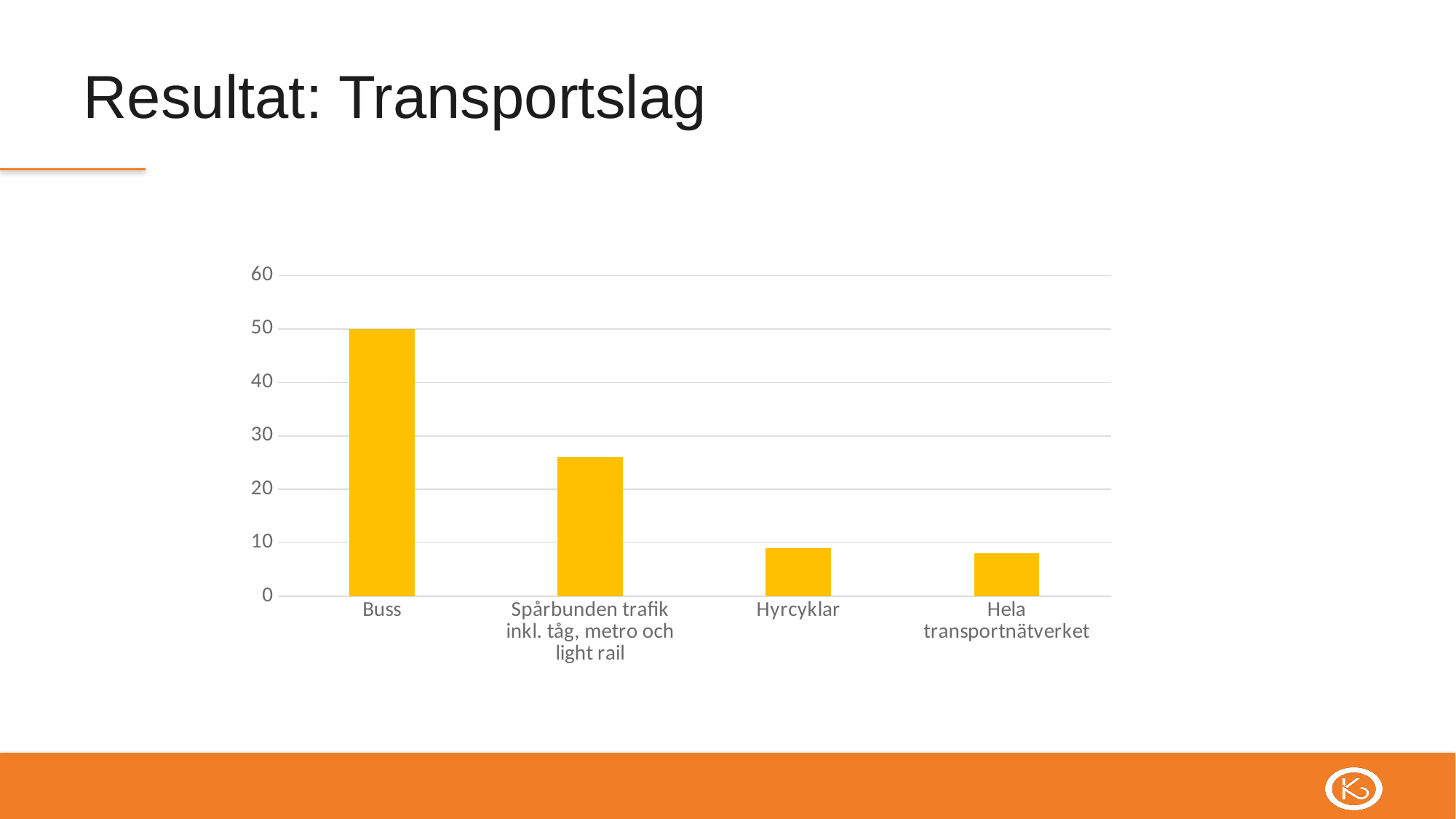
Which is larger, the value for Spårbunden trafik inkl. tåg, metro och light rail or the value for Hyrcyklar? Spårbunden trafik inkl. tåg, metro och light rail Which category has the highest value in the chart? Buss What is the value for Buss? 50 Is the value for Hela transportnätverket greater or less than 10? less Is the value for Spårbunden trafik inkl. tåg, metro och light rail greater or less than 30? less Do the values rise or fall from left to right along the x axis? fall Is the value for Spårbunden trafik inkl. tåg, metro och light rail greater or less than 20? greater What kind of chart is shown on the slide? Bar chart How many categories are shown on the x axis of the chart? 4 What is the title of the slide containing the chart? Resultat: Transportslag Which is larger, the value for Buss or the value for Spårbunden trafik inkl. tåg, metro och light rail? Buss